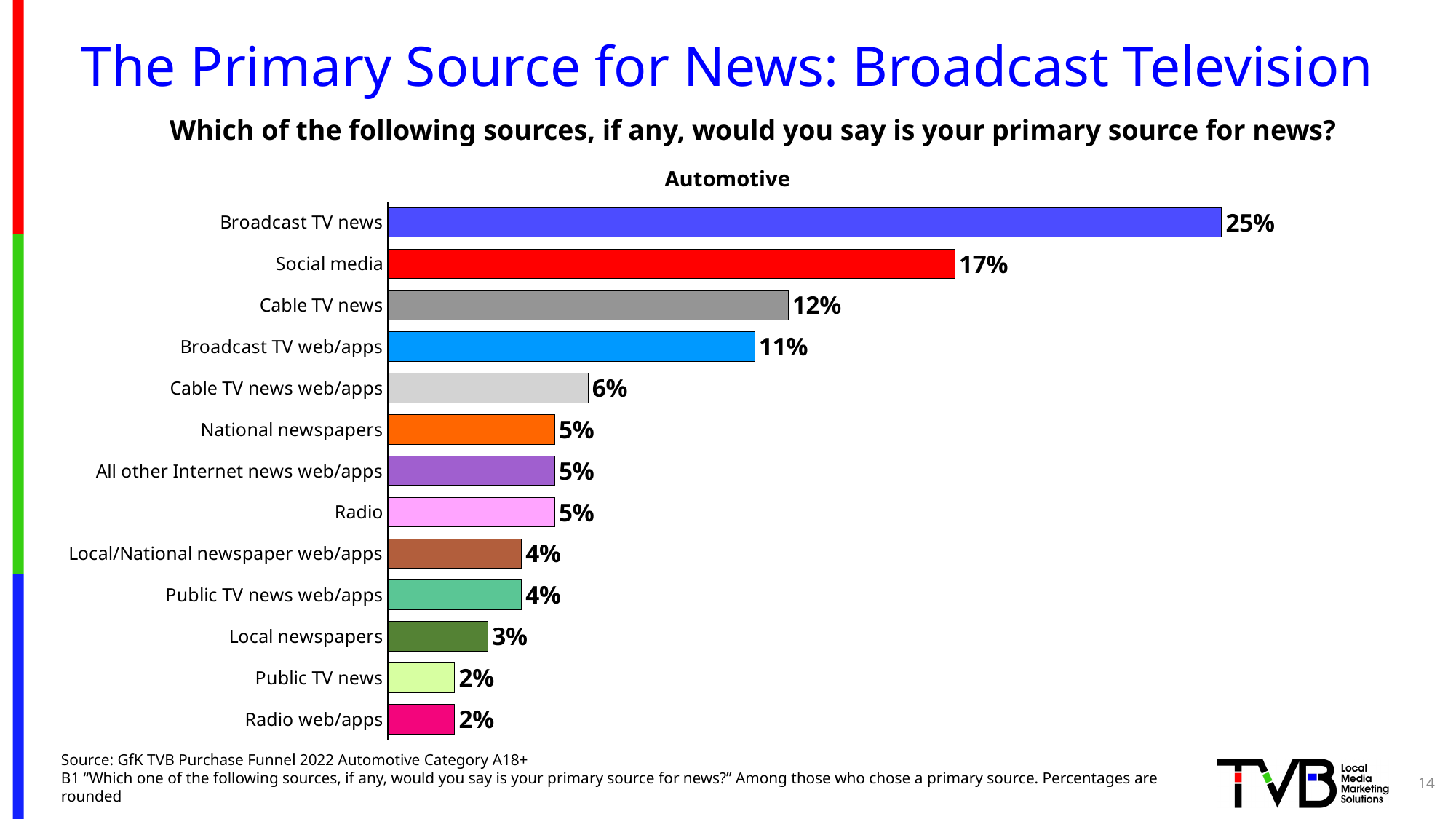
Which is larger, the value for Cable TV news web/apps or the value for Local newspapers? Cable TV news web/apps How many news sources are listed in the chart? 13 What is the value for Local newspapers? 3% What is the value shown for Social media? 17% What kind of chart is shown on the slide? Bar chart What is the difference in percentage points between Broadcast TV news and Social media? 8 What percentage of respondents named Broadcast TV news as their primary source for news? 25% What percentage is shown for Cable TV news web/apps? 6% What is the title of the chart? Automotive What is the difference between Cable TV news and Broadcast TV web/apps? 1 Which is larger, the value for Social media or the value for Cable TV news? Social media Which source has the highest percentage in the chart? Broadcast TV news